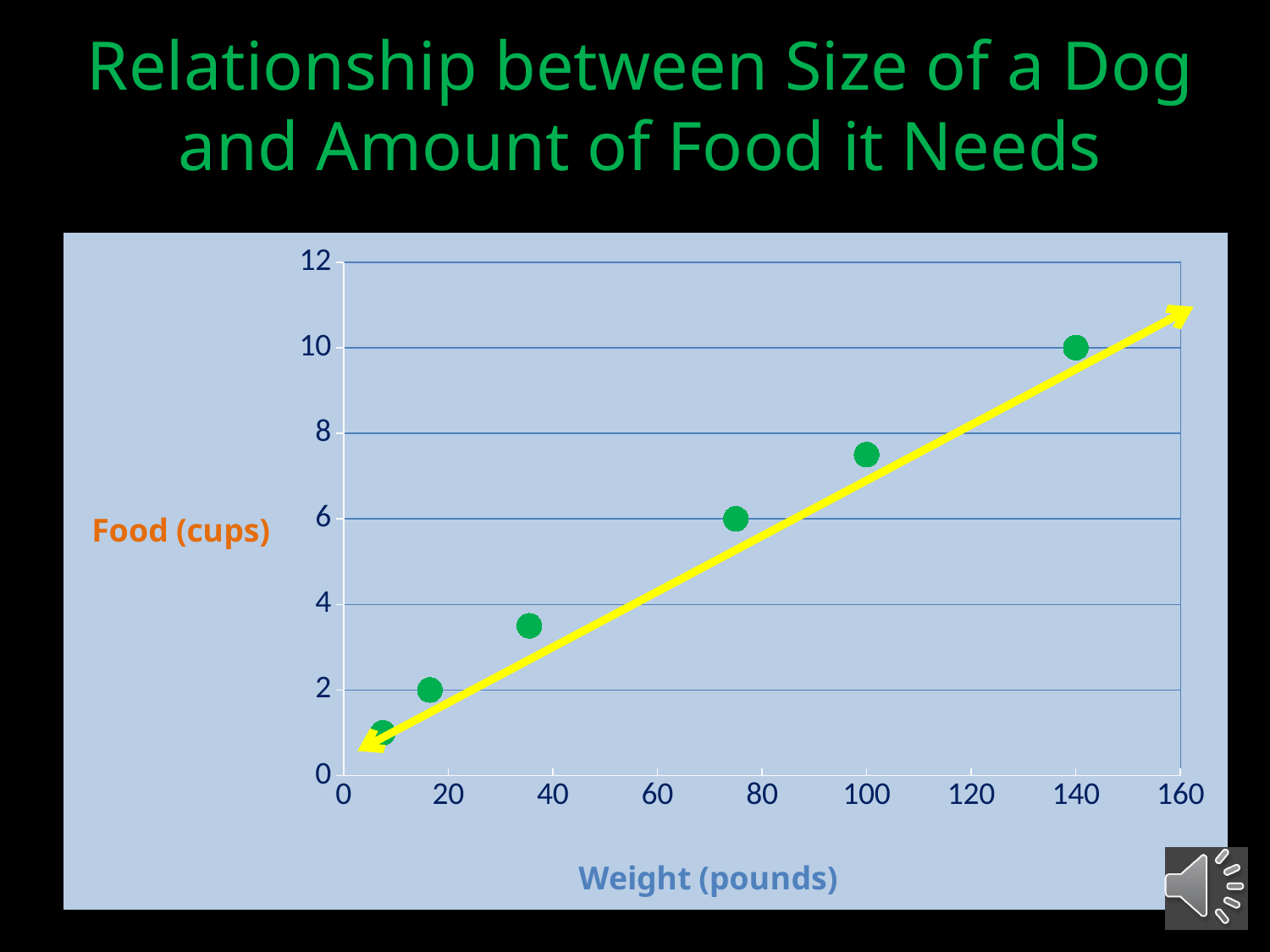
Which needs more food: the dog weighing 100 pounds or the dog weighing 140 pounds? the dog weighing 140 pounds Is the food value for the dog weighing 100 pounds greater or less than 8 cups? less What is the label on the x axis? Weight (pounds) How many data points are plotted on the chart? 6 How many cups of food does the dog weighing 140 pounds need, according to the chart? 10 What is the weight of the dog that needs 10 cups of food? 140 Do the plotted values rise or fall as weight increases along the x axis? rise What kind of chart is shown on the slide? scatter chart Is the food value for the third point from the left greater or less than 4 cups? less Is the food value for the dog weighing 100 pounds greater or less than 6 cups? greater What is the label on the y axis? Food (cups) Which plotted point has the highest food value? the point at 140 pounds